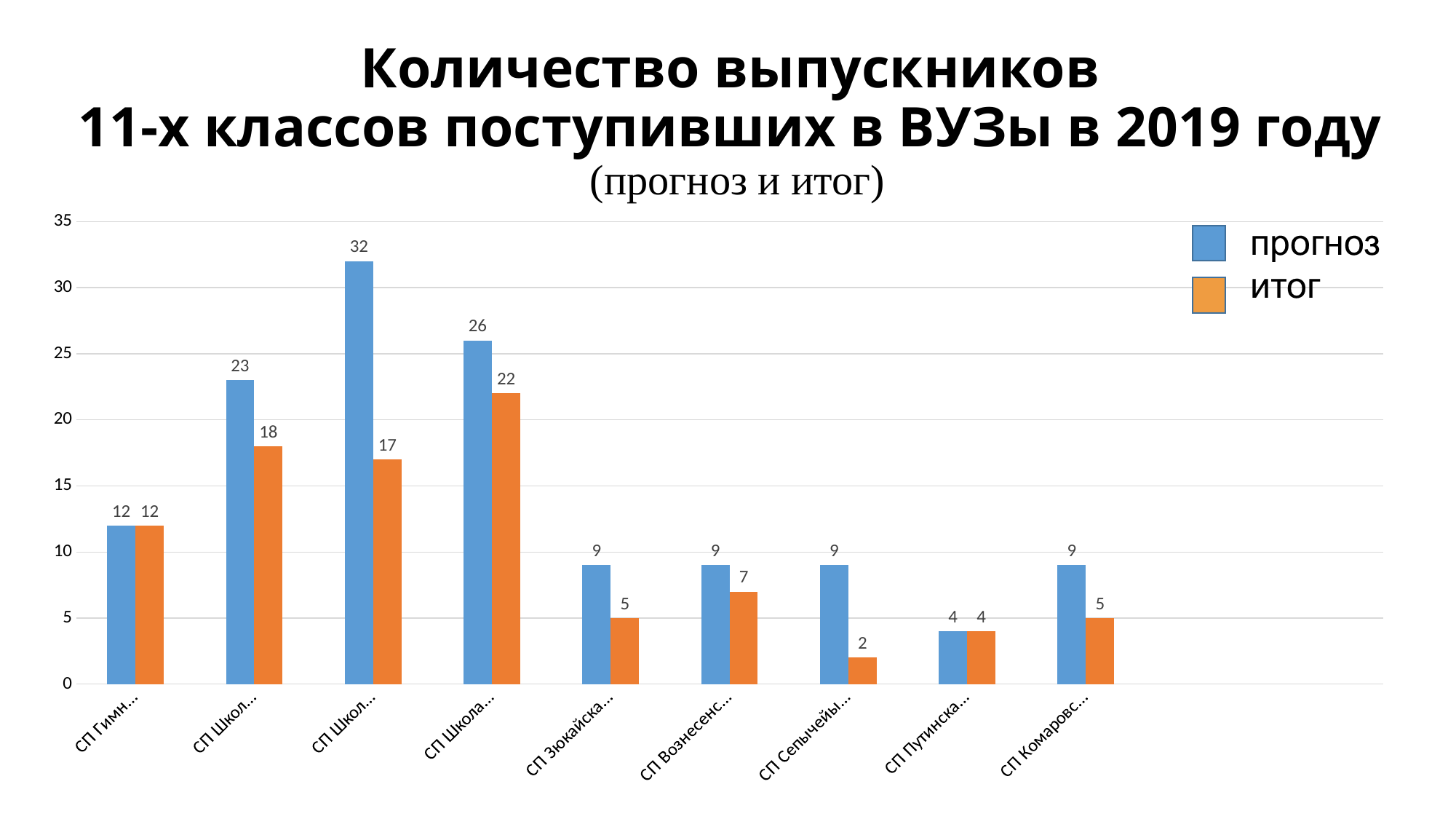
What is the итог value for СП Зюкайска...? 5 For СП Гимн..., which is larger, the прогноз value or the итог value? they are equal What is the итог value for СП Сепычейы...? 2 What is the прогноз value for СП Вознесенс...? 9 Is the прогноз value for СП Путинска... greater or less than 5? less How many categories are plotted along the x axis? 9 What kind of chart is shown on the slide? bar chart How many series does the legend list? 2 What is the difference between the прогноз and итог values for СП Комаровс...? 4 What is the highest прогноз value shown in the chart? 32 Which category has the lowest итог value? СП Сепычейы... Which colour represents the итог series in the legend? orange